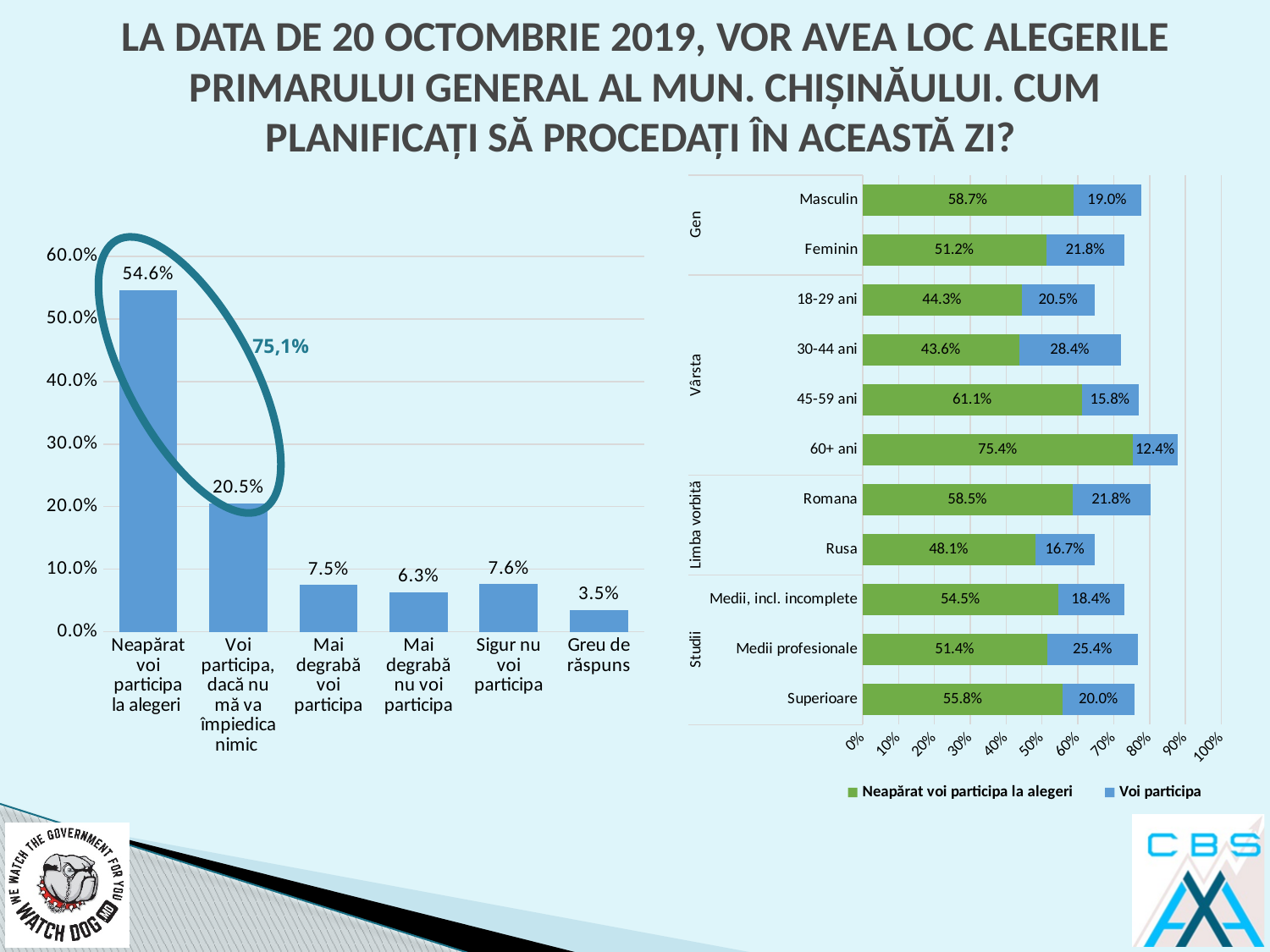
How many categories are shown in the left chart? 6 In the left chart, what is the difference between "Neapărat voi participa la alegeri" and "Voi participa, dacă nu mă va împiedica nimic"? 34.1% What type of chart is the left chart? bar chart In the right chart, what is the difference between the "Neapărat voi participa la alegeri" values for "Romana" and "Rusa"? 10.4% In the left chart, which is larger: "Mai degrabă voi participa" or "Sigur nu voi participa"? Sigur nu voi participa In the right chart, what is the value of "Neapărat voi participa la alegeri" for "60+ ani"? 75.4% In the right chart, what is the total of the stacked bar for "Masculin"? 77.7% How many series does the legend of the right chart list? 2 In the right chart, what is the value of "Voi participa" for "30-44 ani"? 28.4% In the left chart, what is the value for "Neapărat voi participa la alegeri"? 54.6% In the right chart, which category has the highest value for "Neapărat voi participa la alegeri"? 60+ ani In the left chart, which category has the lowest value? Greu de răspuns